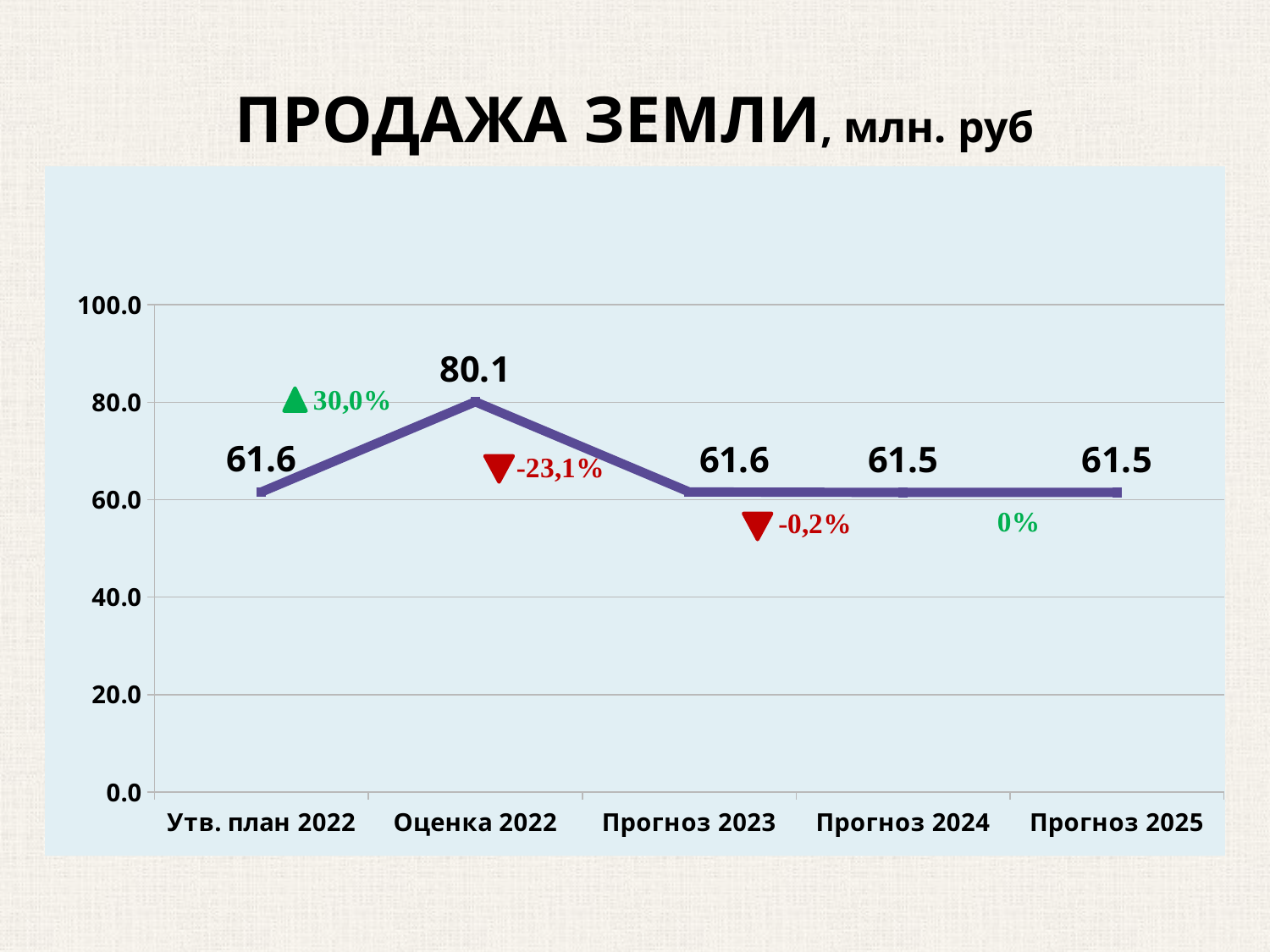
Is the value for Прогноз 2023 greater or less than 80.0? less What kind of chart is shown on the slide? line chart Which is larger, the value for Оценка 2022 or the value for Прогноз 2025? Оценка 2022 What is the value for Оценка 2022? 80.1 Which category has the highest value? Оценка 2022 Is the value for Оценка 2022 greater or less than 80.0? greater What is the difference between the values for Оценка 2022 and Прогноз 2023? 18.5 What is the value for Прогноз 2024? 61.5 Does the value rise or fall from Оценка 2022 to Прогноз 2023? fall How many categories are shown on the x axis? 5 What is the title of the chart? ПРОДАЖА ЗЕМЛИ, млн. руб What is the value for Утв. план 2022? 61.6